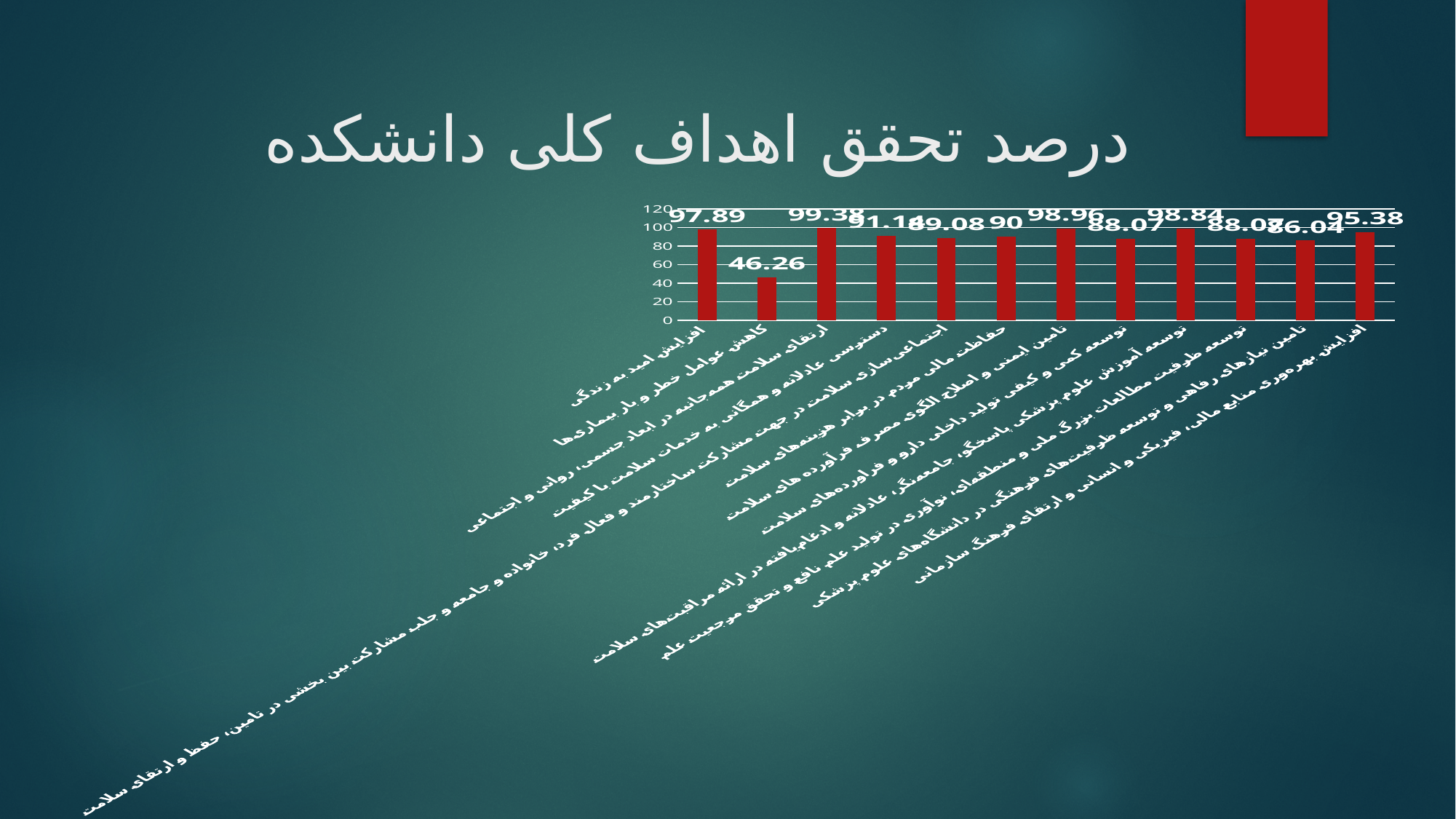
What is the value for the first category, افزایش امید به زندگی? 97.89 How many bars (categories) does the chart show? 12 What is the highest value shown on the chart? 99.38 What is the value for تامین ایمنی و اصلاح الگوی مصرف فرآورده‌های سلامت? 98.96 Which category has the lowest value? کاهش عوامل خطر و بار بیماری‌ها What is the difference between the highest value (99.38) and the lowest value (46.26)? 53.12 What kind of chart is shown on the slide? bar chart What colour are the bars in the chart? red What is the value for کاهش عوامل خطر و بار بیماری‌ها? 46.26 What is the title of the slide above the chart? درصد تحقق اهداف کلی دانشکده Is the value for کاهش عوامل خطر و بار بیماری‌ها greater or less than 60? less What is the value for the last category, افزایش بهره‌وری منابع مالی، فیزیکی و انسانی و ارتقای فرهنگ سازمانی? 95.38